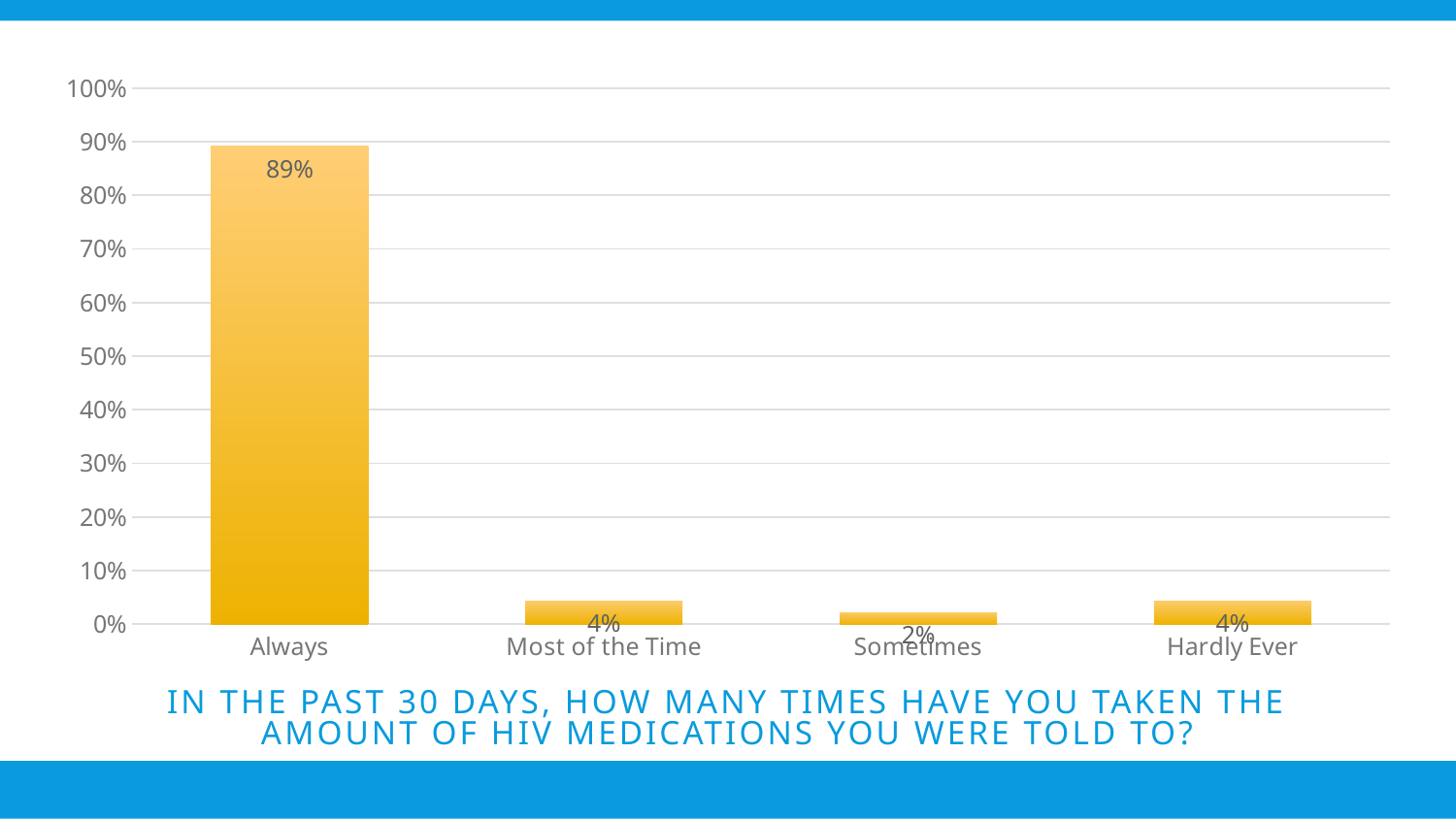
What percentage of respondents answered "Always"? 89% What percentage of respondents answered "Most of the Time"? 4% What kind of chart is shown on the slide? Bar chart Which response category has the lowest percentage? Sometimes What is the highest value shown on the y axis? 100% Which is larger, the value for "Always" or the value for "Hardly Ever"? Always What is the difference in percentage points between "Hardly Ever" and "Sometimes"? 2 How many response categories are shown on the x axis? 4 Which response category has the highest percentage? Always Is the value for "Always" greater or less than 80%? greater What is the difference in percentage points between "Always" and "Most of the Time"? 85 What percentage of respondents answered "Sometimes"? 2%